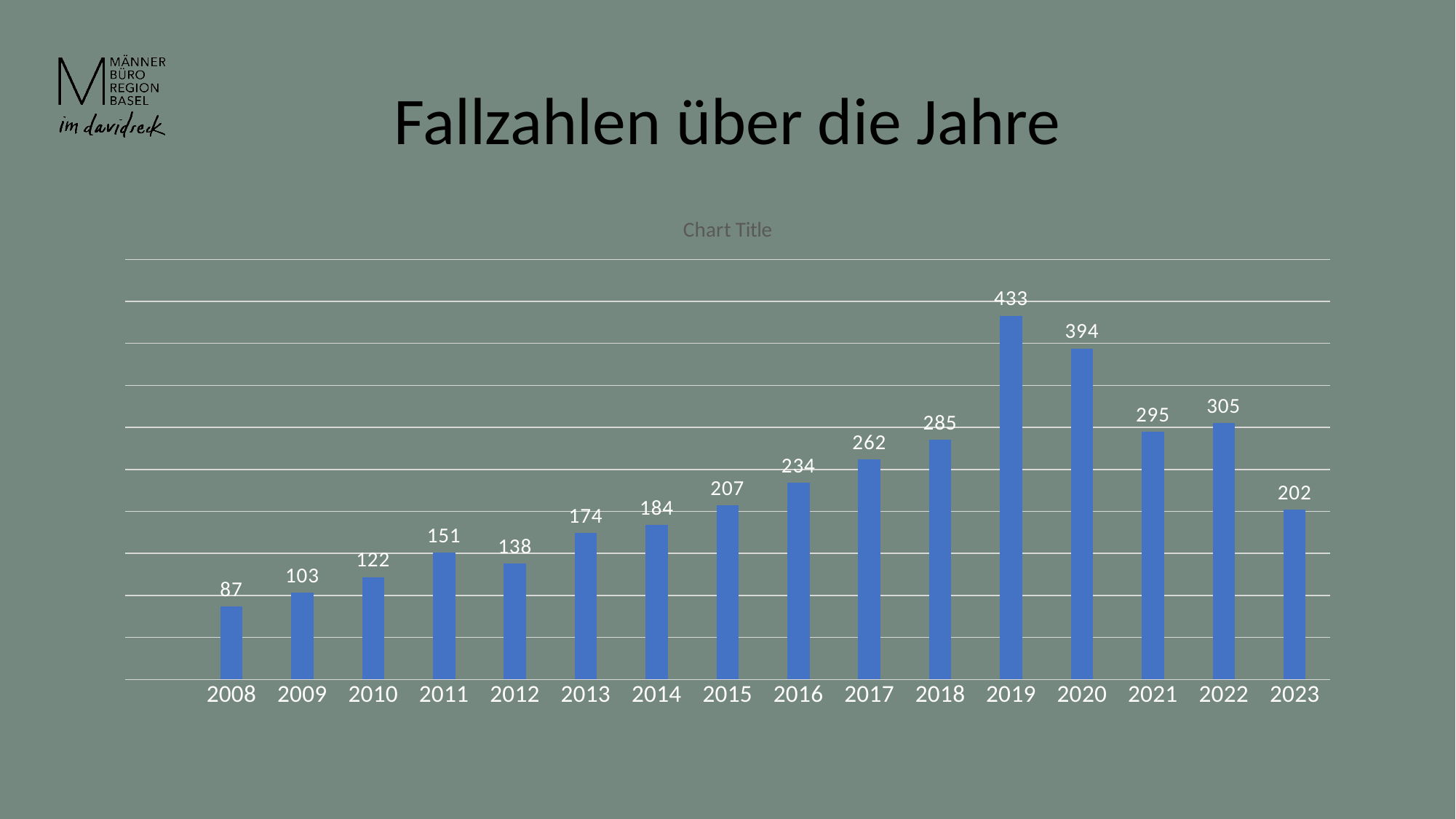
Do the values rise or fall from 2008 to 2019? rise What is the value for 2019? 433 What kind of chart is shown on the slide? bar chart How many years are shown on the x axis? 16 What is the difference between the values for 2019 and 2020? 39 Which is larger, the value for 2021 or the value for 2022? 2022 What is the difference between the values for 2022 and 2023? 103 Which year has the lowest value? 2008 Which year has the highest value? 2019 What is the value for 2008? 87 What is the slide title? Fallzahlen über die Jahre What is the value for 2023? 202